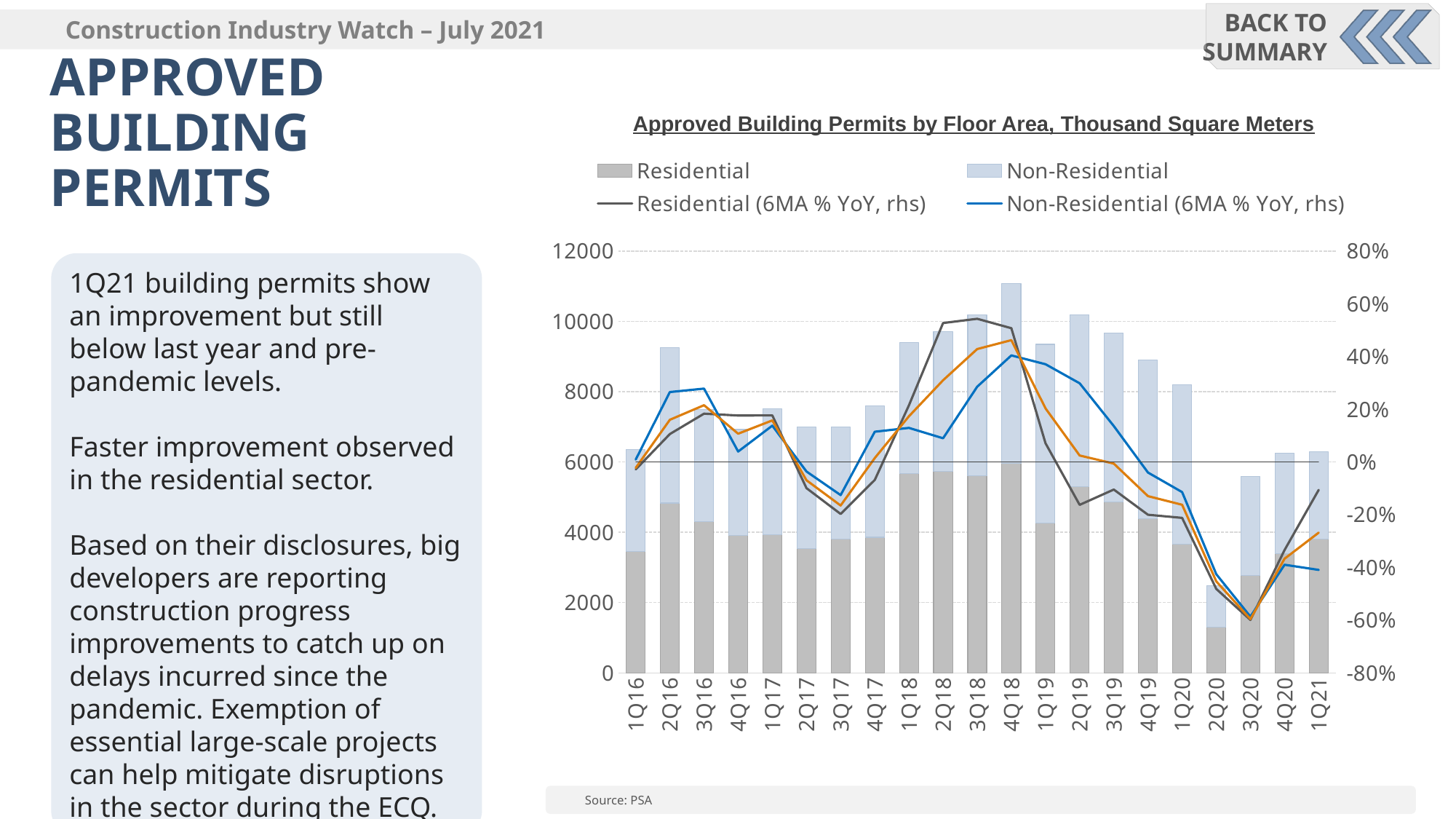
Do the total stacked bars rise or fall from 4Q18 to 2Q20? fall How many series does the chart legend list? 4 Is the Residential value for 1Q16 greater or less than 4000? less Is the total stacked bar for 4Q18 greater or less than 10000? greater Is the Residential value for 2Q20 greater or less than 2000? less What kind of chart is used to show the Approved Building Permits by Floor Area? A stacked bar chart combined with line series Which quarter has the lowest total approved floor area (shortest stacked bar)? 2Q20 How many quarters are shown along the x axis of the chart? 21 Which quarter has the highest total approved floor area (tallest stacked bar)? 4Q18 Which quarter has the larger total stacked bar, 2Q16 or 3Q16? 2Q16 What is the title of the chart? Approved Building Permits by Floor Area, Thousand Square Meters